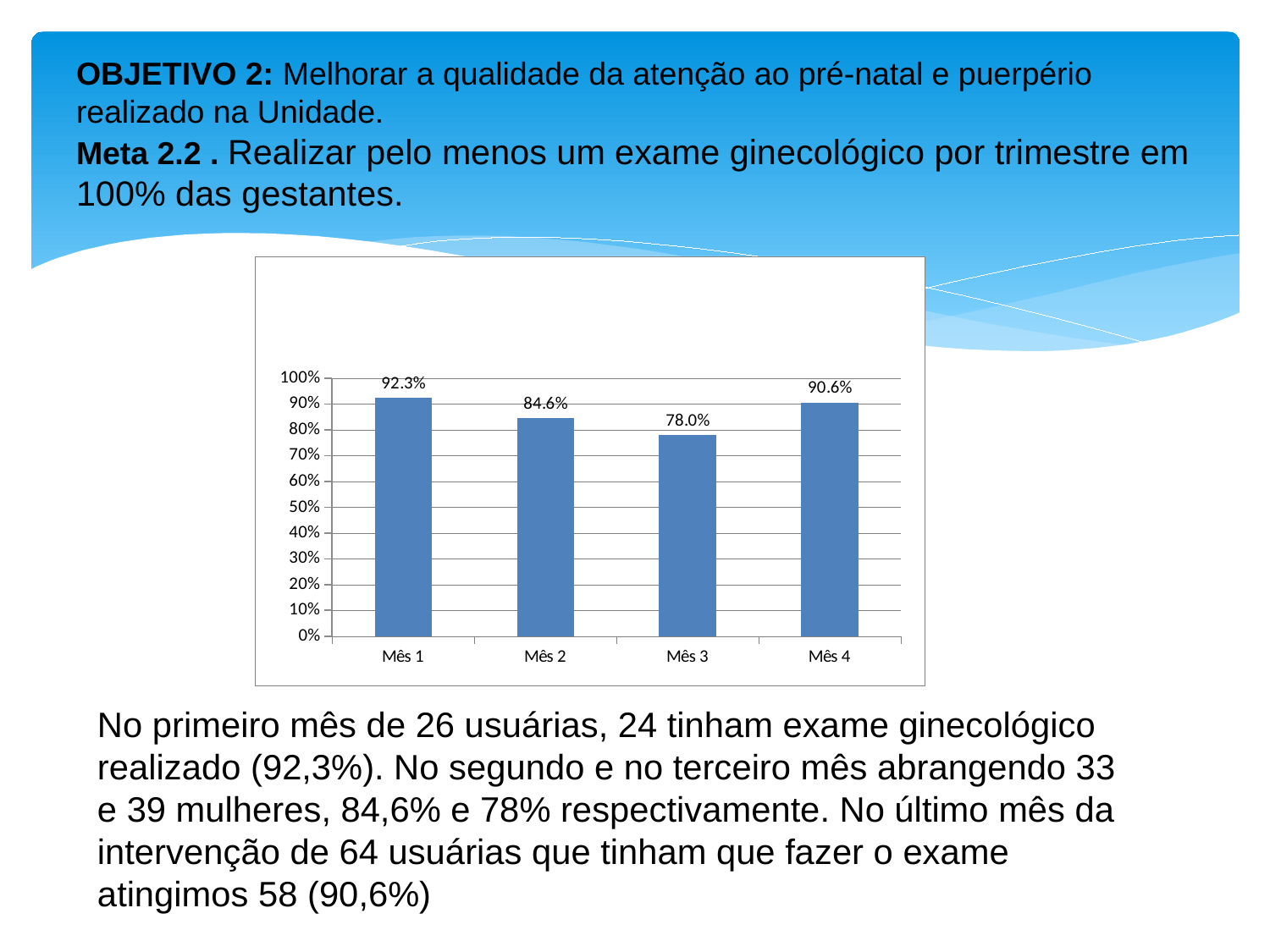
What is the value for Mês 1? 92.3% What is the value for Mês 3? 78.0% What is the value for Mês 4? 90.6% How many months are shown on the x axis? 4 What is the difference between the values for Mês 1 and Mês 3? 14.3% Which month has the lowest value? Mês 3 Is the value for Mês 3 greater or less than 80%? less What kind of chart is shown on the slide? bar chart Which month has the highest value? Mês 1 What is the maximum value shown on the y axis? 100% What is the difference between the values for Mês 4 and Mês 2? 6.0% Which is larger, the value for Mês 2 or the value for Mês 4? Mês 4